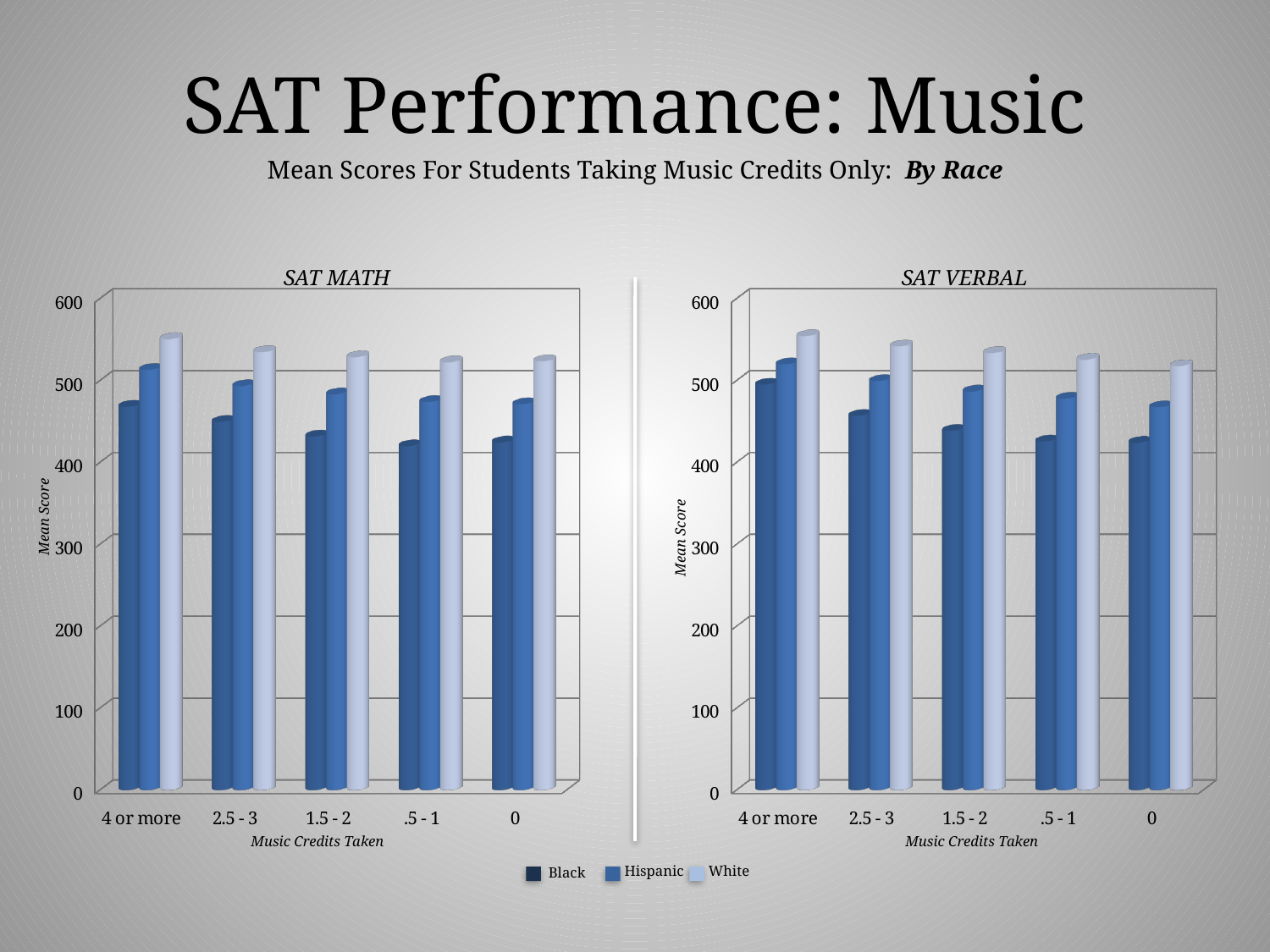
In the SAT MATH chart, is the value for Black students with 0 music credits greater or less than 500? less What kind of chart is the SAT MATH chart? bar chart In the SAT MATH chart, is the value for White students with 4 or more music credits greater or less than 500? greater What is the label on the vertical axis of the SAT VERBAL chart? Mean Score What is the label on the horizontal axis of the SAT MATH chart? Music Credits Taken In the SAT VERBAL chart, is the value for White students with 4 or more music credits greater or less than 500? greater In the SAT MATH chart, for students with 4 or more music credits, which is larger: the Black bar or the White bar? White How many music-credit categories are shown on the x axis of the SAT VERBAL chart? 5 In the SAT VERBAL chart, do the Black bars generally rise or fall moving from '4 or more' to '0' music credits? fall How many series does the legend list? 3 In the SAT MATH chart, which series has the highest bar in every music-credit category? White